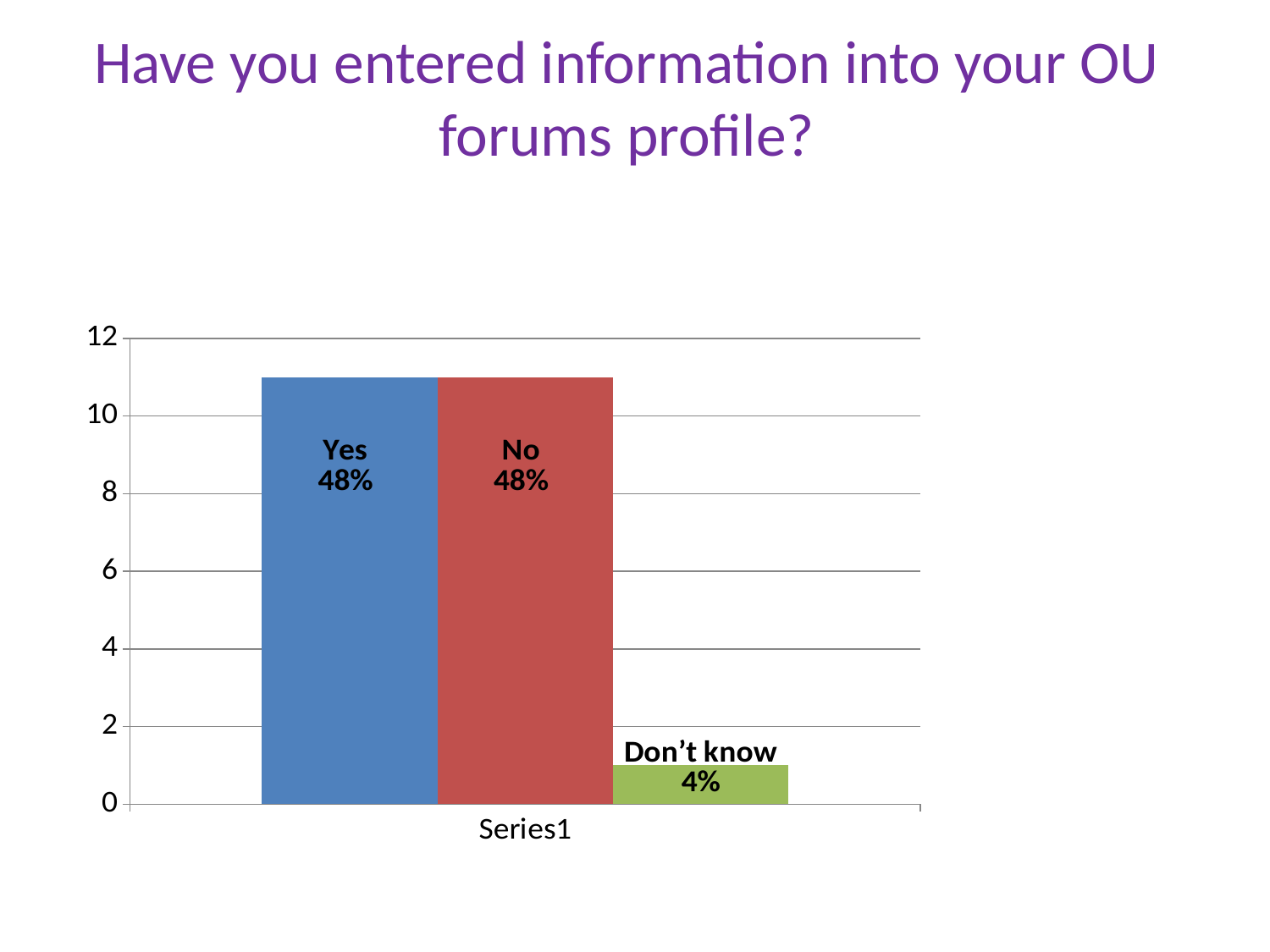
What percentage is shown on the Yes bar? 48% What percentage is shown on the Don't know bar? 4% Which response has the lowest bar? Don't know Is the value for Don't know greater or less than 2 on the vertical axis? less Which is larger, the Yes bar or the Don't know bar? Yes What is the title of the slide above the chart? Have you entered information into your OU forums profile? What kind of chart is shown on the slide? Bar chart What percentage is shown on the No bar? 48% How many bars are plotted in the chart? 3 What colour is the Don't know bar? Green Is the value for Yes greater or less than 10 on the vertical axis? greater What is the difference in percentage points between the Yes bar and the Don't know bar? 44%